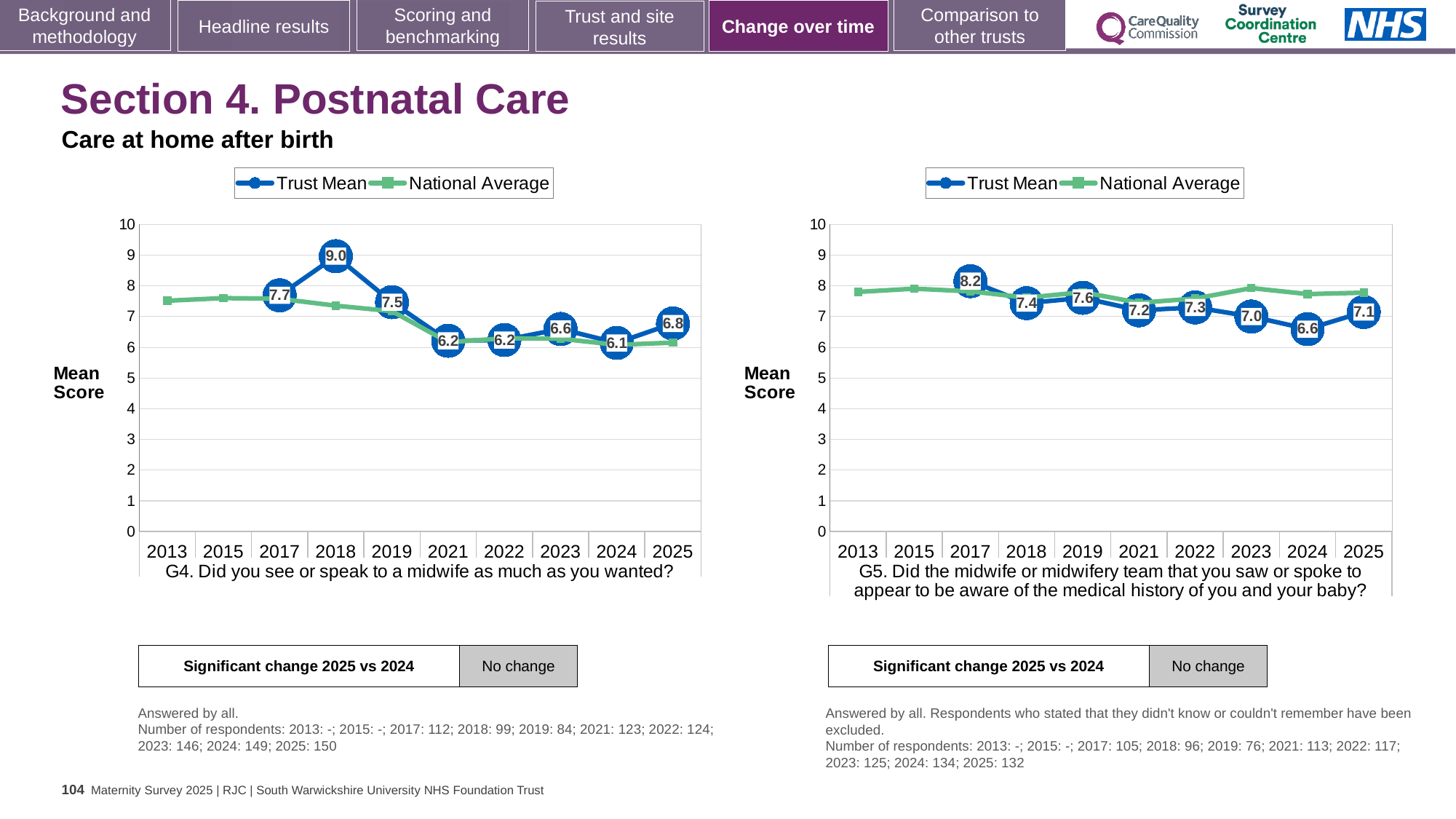
In the G5 chart (right), is the Trust Mean higher in 2019 or in 2023? 2019 In the G4 chart (left), which year has the lowest Trust Mean? 2024 In the G4 chart (left), what is the Trust Mean for 2025? 6.8 In the G4 chart (left), which year has the highest Trust Mean? 2018 In the G4 chart (left), what is the Trust Mean for 2018? 9.0 What kind of chart is the G5 chart (right)? Line chart In the G5 chart (right), which year has the lowest Trust Mean? 2024 In the G5 chart (right), what is the Trust Mean for 2024? 6.6 In the G5 chart (right), what is the Trust Mean for 2017? 8.2 In the G5 chart (right), is the National Average for 2023 greater or less than 7? greater In the G4 chart (left), what is the difference between the Trust Mean in 2018 and in 2019? 1.5 How many series does the legend of the G4 chart (left) list? 2